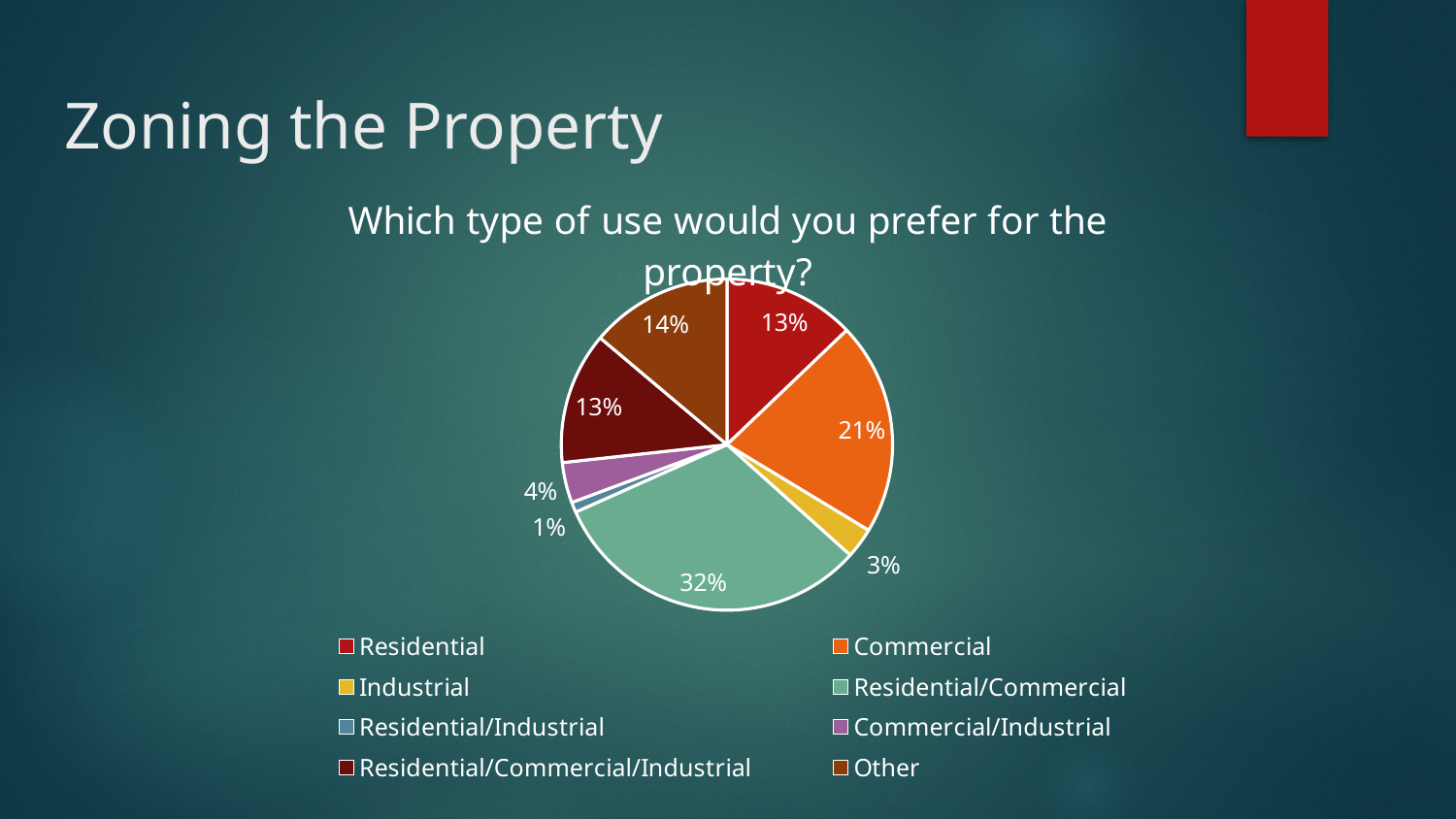
How many categories does the legend list? 8 What share of the pie does Residential/Commercial have? 32% What is the value for Industrial? 3% What is the value for Residential/Industrial? 1% What type of chart is shown on the slide? Pie chart Which category has the smallest slice of the pie? Residential/Industrial Which category has the largest slice of the pie? Residential/Commercial What is the title of the chart? Which type of use would you prefer for the property? What is the value for Commercial? 21% Which is larger, Other or Commercial/Industrial? Other What is the value for Other? 14% What is the difference between the Commercial and Residential shares? 8%